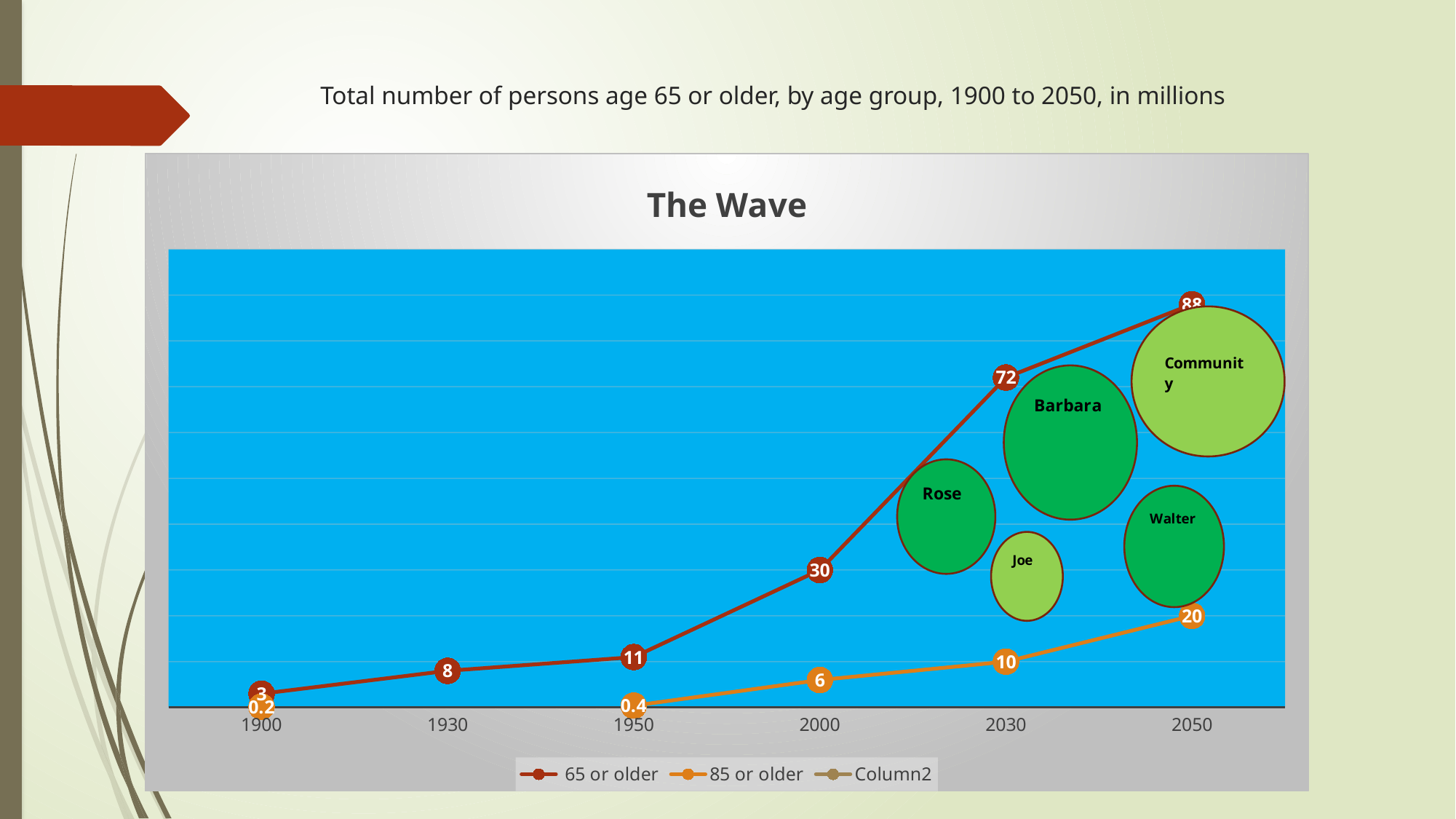
In which year is the 85 or older series at its lowest value? 1900 Which is larger in 2030: the 65 or older value or the 85 or older value? 65 or older What is the value for the 65 or older series in 2030? 72 What is the title of the chart? The Wave What is the value for the 85 or older series in 2000? 6 How many series does the legend list? 3 How many years are shown on the x axis? 6 What is the difference between the 65 or older and 85 or older values in 2050? 68 In which year does the 65 or older series reach its highest value? 2050 What kind of chart is shown on the slide? Line chart What is the value for the 85 or older series in 2050? 20 What is the value for the 65 or older series in 1900? 3